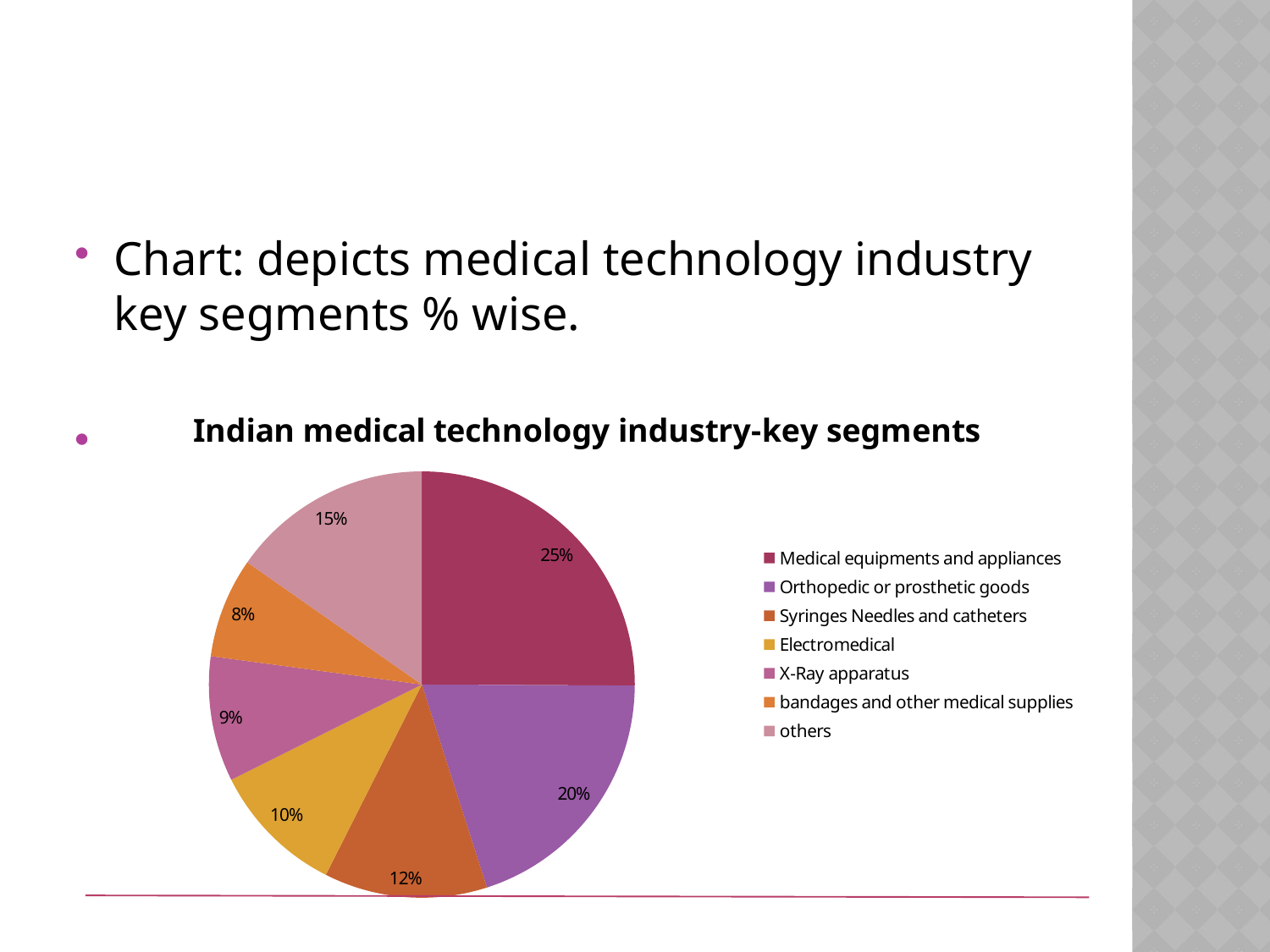
What type of chart is shown on the slide? pie chart How many segments does the legend list? 7 What percentage is shown for Orthopedic or prosthetic goods? 20% What is the value for Syringes Needles and catheters? 12% What is the title of the chart? Indian medical technology industry-key segments What share of the pie does Medical equipments and appliances hold? 25% What is the share for X-Ray apparatus? 9% Which segment has the largest share of the pie? Medical equipments and appliances Which segment has the smallest share of the pie? bandages and other medical supplies What is the difference in percentage points between Medical equipments and appliances and Orthopedic or prosthetic goods? 5 What percentage is shown for bandages and other medical supplies? 8% What percentage does the Electromedical segment account for? 10%